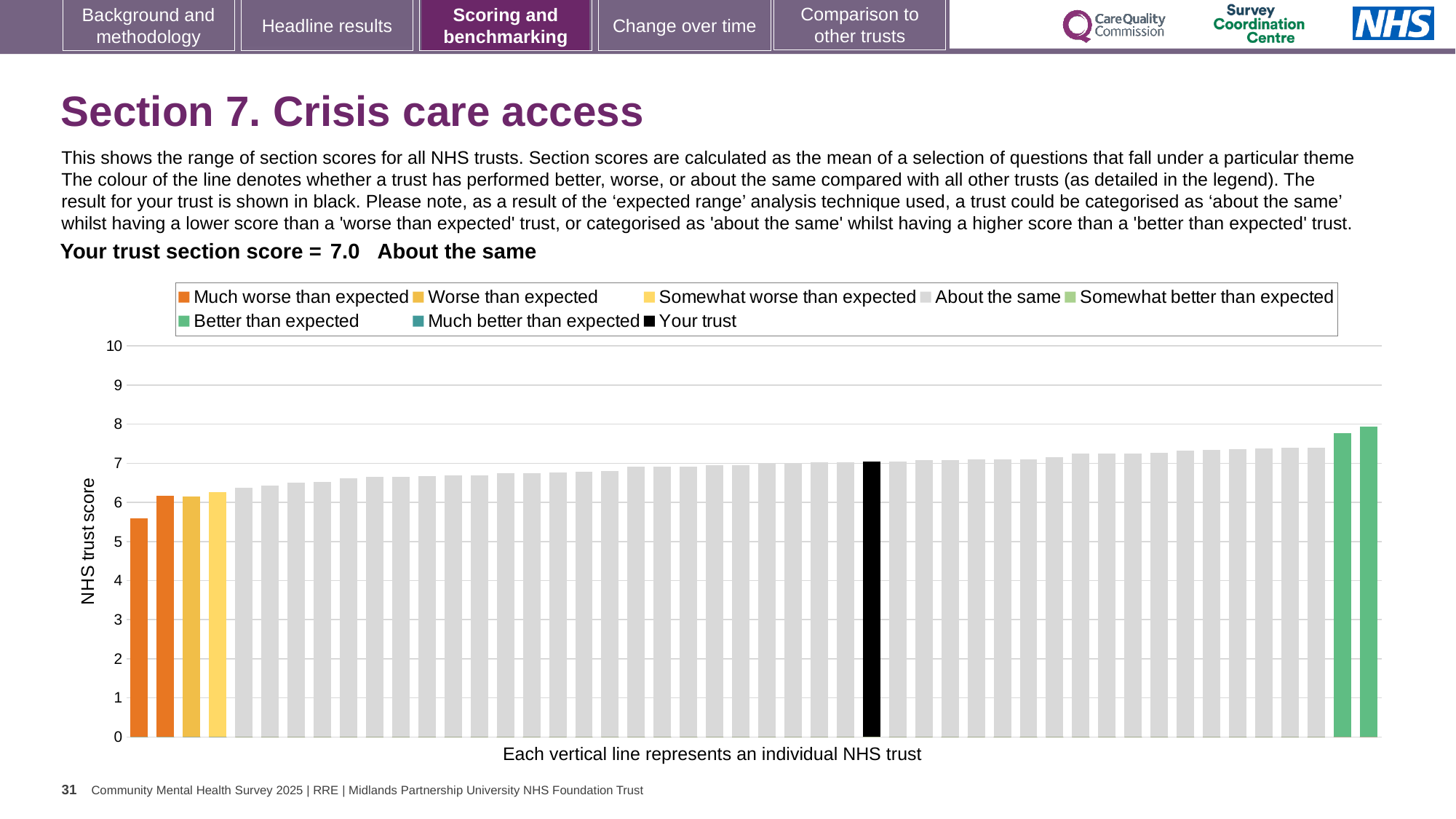
Is the value of the lowest (leftmost) bar greater or less than 6? less How many entries does the chart legend list? 8 What is the section score for your trust shown on the slide? 7.0 What is the label on the vertical axis of the chart? NHS trust score Do the bar values rise or fall moving from left to right along the x axis? rise Is the value of the highest (rightmost) bar greater or less than 7? greater What kind of chart is shown on the slide? bar chart Which is larger: the black 'Your trust' bar or the leftmost orange bar? the black 'Your trust' bar Which legend category does the lowest bar on the chart belong to? Much worse than expected How many bars are coloured as 'Much worse than expected'? 2 Which legend category does the highest bar on the chart belong to? Better than expected Which performance category is your trust placed in for this section? About the same